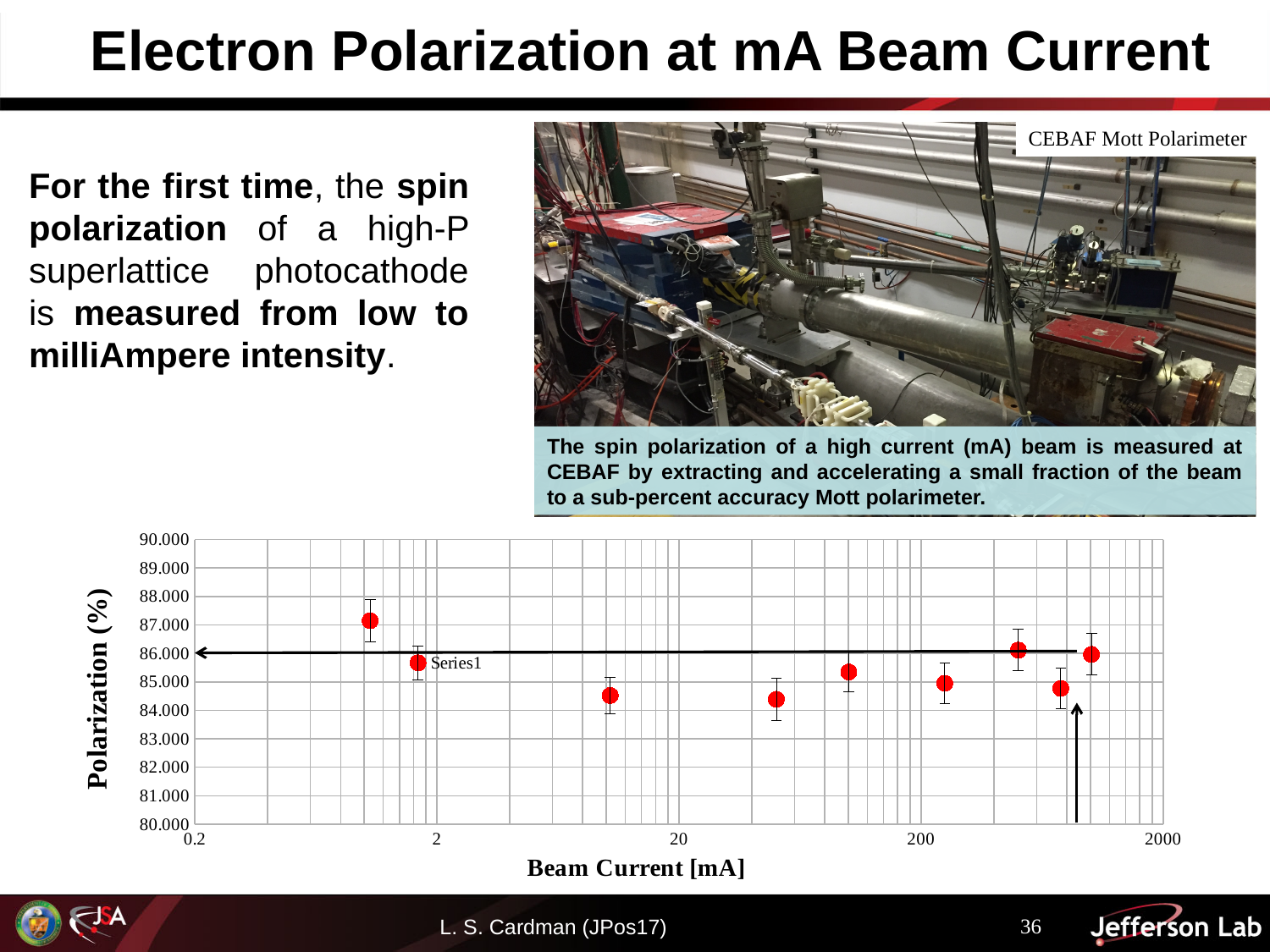
What is the maximum value shown on the chart's y-axis? 90.000 Is the polarization value of the rightmost data point (highest beam current) greater or less than 85? greater What is the label of the chart's x-axis? Beam Current [mA] Which data point has the highest polarization: the one at the lowest beam current or the one at the highest beam current? The one at the lowest beam current Is the polarization of the data point near 50 mA greater or less than 86? less Is the polarization value of the data point near 10 mA greater or less than 86? less What kind of chart is shown at the bottom of the slide? Scatter chart How many data points are plotted in the chart? 9 How many series does the chart's legend list? 1 What is the label of the chart's y-axis? Polarization (%)